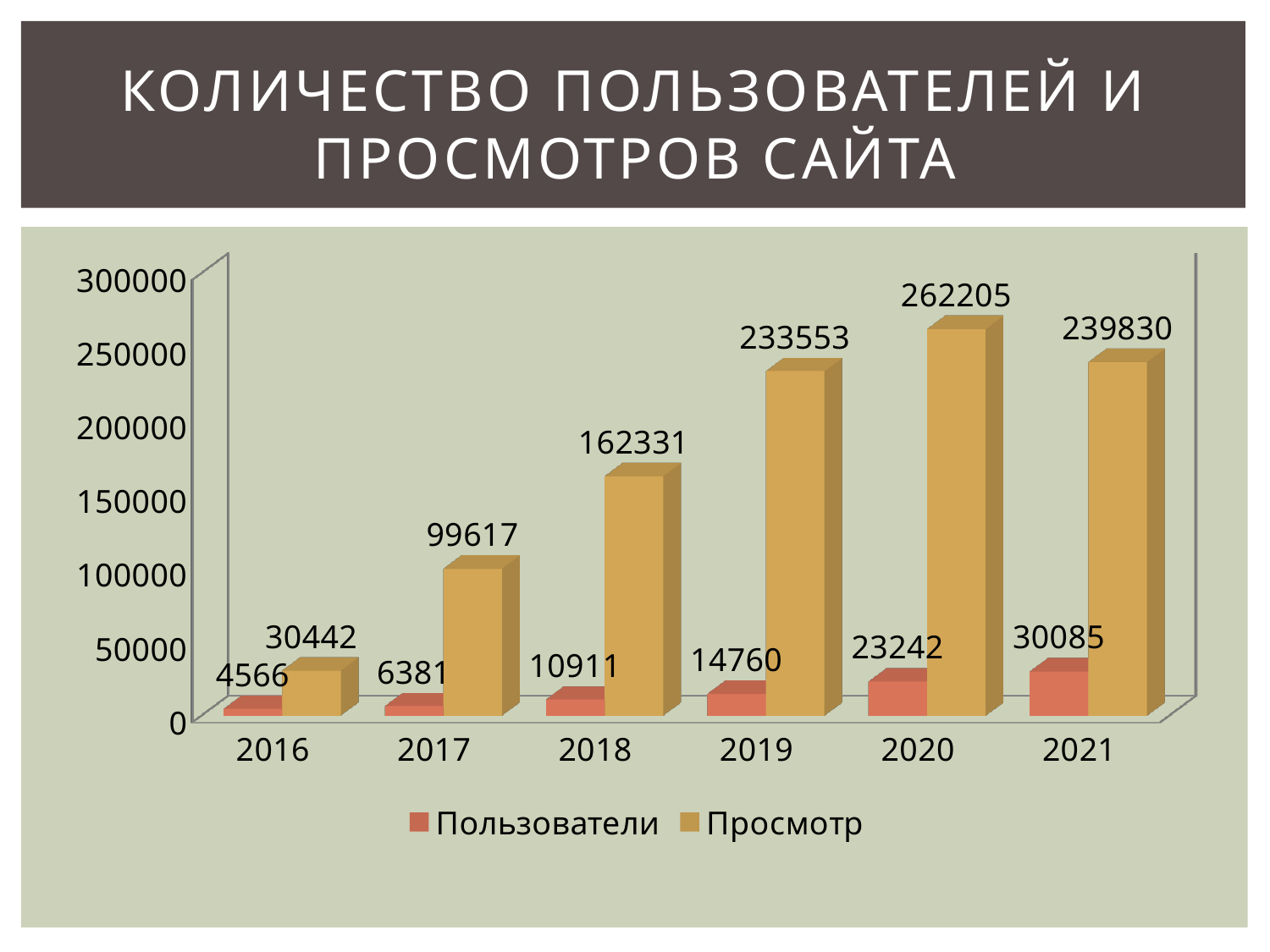
How many years are shown on the x axis? 6 What is the value for Просмотр in 2018? 162331 What is the value for Пользователи in 2021? 30085 What is the difference between the Просмотр values for 2020 and 2021? 22375 Do the Пользователи values rise or fall from 2016 to 2021? rise Which is larger: Просмотр in 2019 or Просмотр in 2021? 2021 Which year has the lowest value for Пользователи? 2016 What kind of chart is shown on the slide? bar chart What is the value for Пользователи in 2016? 4566 How many series does the legend list? 2 Is the value for Просмотр in 2017 greater or less than 100000? less Which year has the highest value for Просмотр? 2020